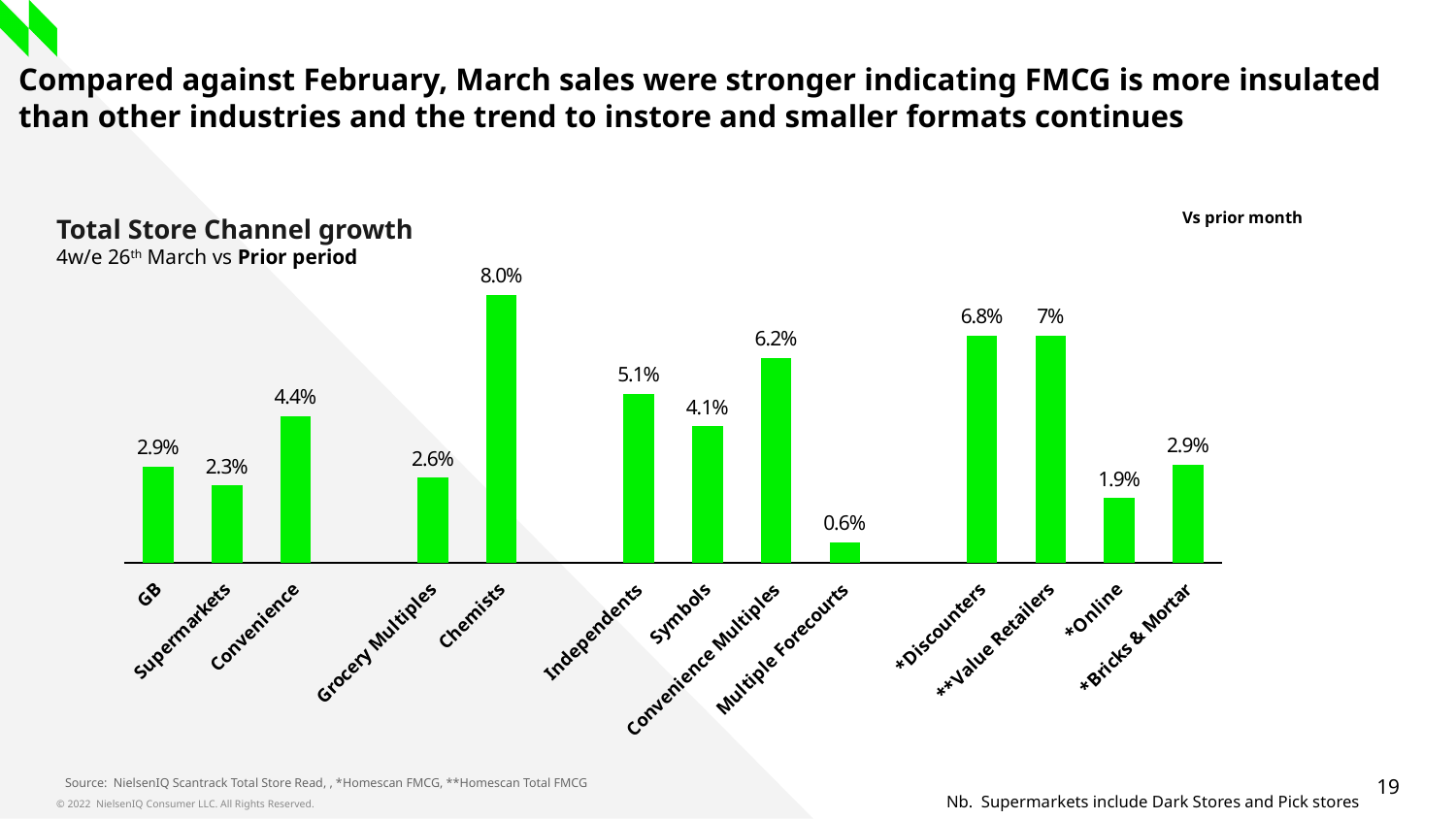
What is the value for *Online? 1.9% Which category has the highest value? Chemists Which category has the lowest value? Multiple Forecourts What kind of chart is shown on the slide? Bar chart What is the value for Multiple Forecourts? 0.6% What is the difference between the values for Independents and Grocery Multiples? 2.5% What is the value for **Value Retailers? 7% What is the difference between the values for Convenience Multiples and Symbols? 2.1% Which is larger, the value for Convenience or the value for Supermarkets? Convenience What is the title of the chart? Total Store Channel growth What is the value for Chemists? 8.0% How many categories are shown in the chart? 13